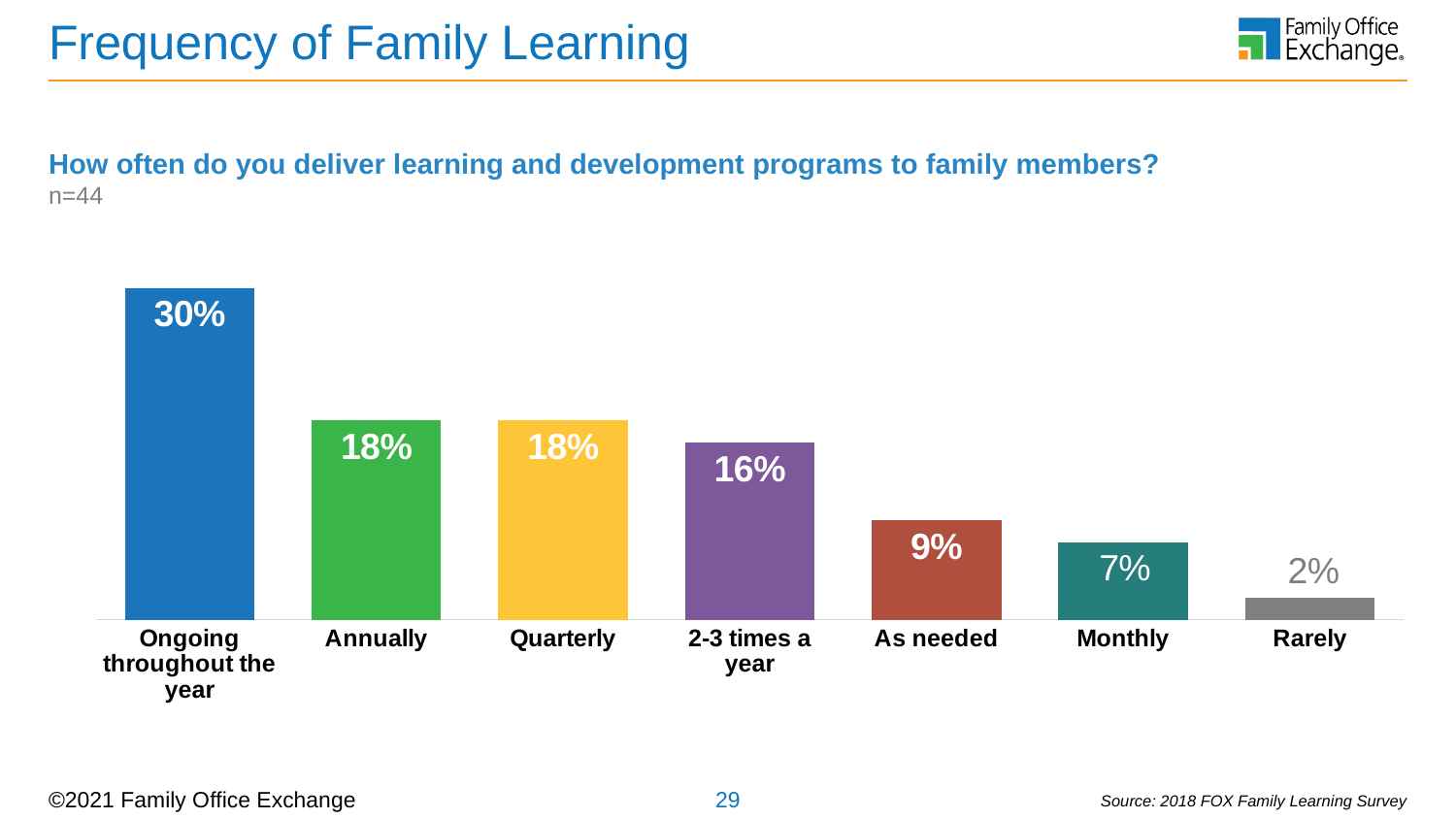
Which is larger, the value for 'Quarterly' or the value for 'As needed'? Quarterly Which category has the lowest value? Rarely What is the difference between the values for '2-3 times a year' and 'Rarely'? 14% What is the sample size (n) stated for the survey question? n=44 What is the difference between the values for 'Ongoing throughout the year' and 'Annually'? 12% What is the value for 'Monthly'? 7% How many categories are shown in the chart? 7 What kind of chart is shown on the slide? Bar chart Which category has the highest value? Ongoing throughout the year Do the values rise or fall from left to right across the categories? Fall What is the value for 'As needed'? 9% What percentage of respondents deliver learning and development programs ongoing throughout the year? 30%